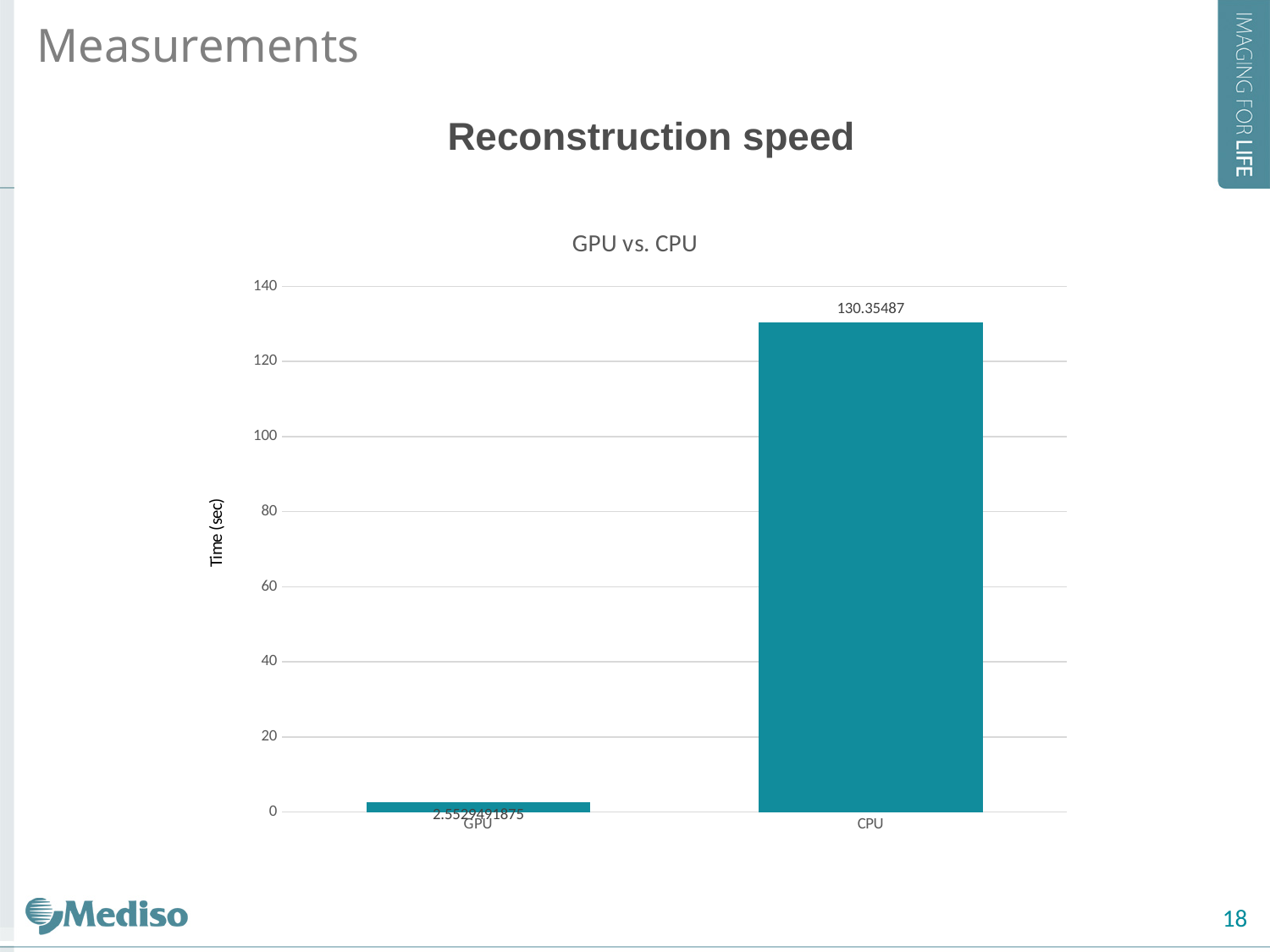
What is the title of the chart on the slide? GPU vs. CPU What is the difference between the CPU and GPU values in the GPU vs. CPU chart? 127.8019208125 Is the value for GPU greater or less than 20 in the GPU vs. CPU chart? less What is the value for CPU in the GPU vs. CPU chart? 130.35487 Which category has the lowest value in the GPU vs. CPU chart? GPU What kind of chart is the GPU vs. CPU chart? bar chart Which category has the highest value in the GPU vs. CPU chart? CPU Which is larger in the GPU vs. CPU chart, the value for GPU or the value for CPU? CPU Is the value for CPU greater or less than 120 in the GPU vs. CPU chart? greater What is the label of the vertical axis in the GPU vs. CPU chart? Time (sec) How many categories are shown in the GPU vs. CPU chart? 2 What is the value for GPU in the GPU vs. CPU chart? 2.5529491875